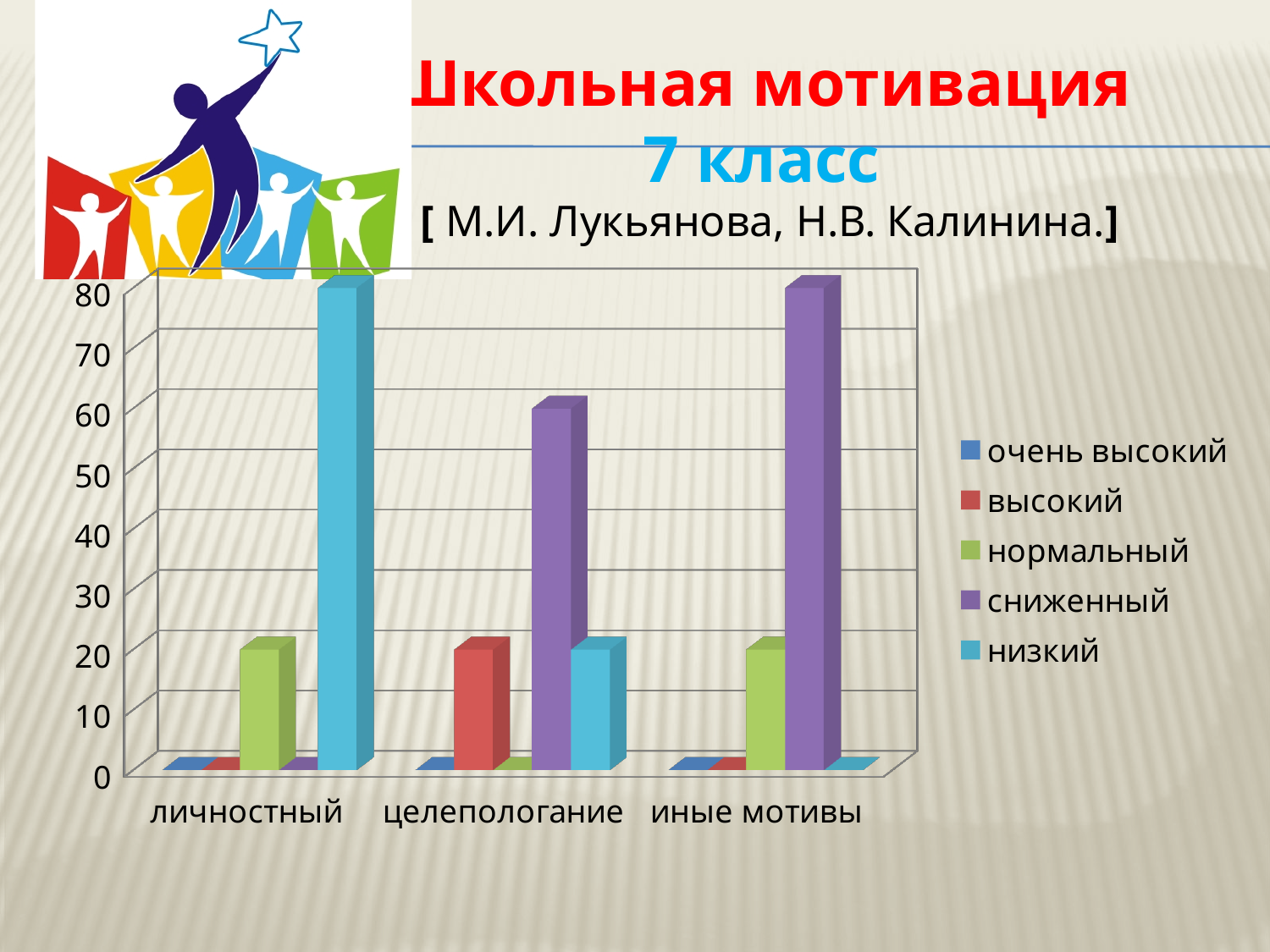
Which legend entry is shown in purple? сниженный How many categories are shown on the x axis of the chart? 3 What kind of chart is shown on the slide? bar chart How many series does the chart legend list? 5 Is the value of низкий for личностный greater or less than 70? greater Which is larger: the сниженный bar for целеполагание or the сниженный bar for иные мотивы? иные мотивы Which series has the tallest bar in the иные мотивы category? сниженный Is the value of нормальный for иные мотивы greater or less than 30? less Which is larger: the низкий bar for личностный or the низкий bar for целеполагание? личностный Which series has the tallest bar in the личностный category? низкий Which series has the tallest bar in the целеполагание category? сниженный Is the value of сниженный for целеполагание greater or less than 50? greater